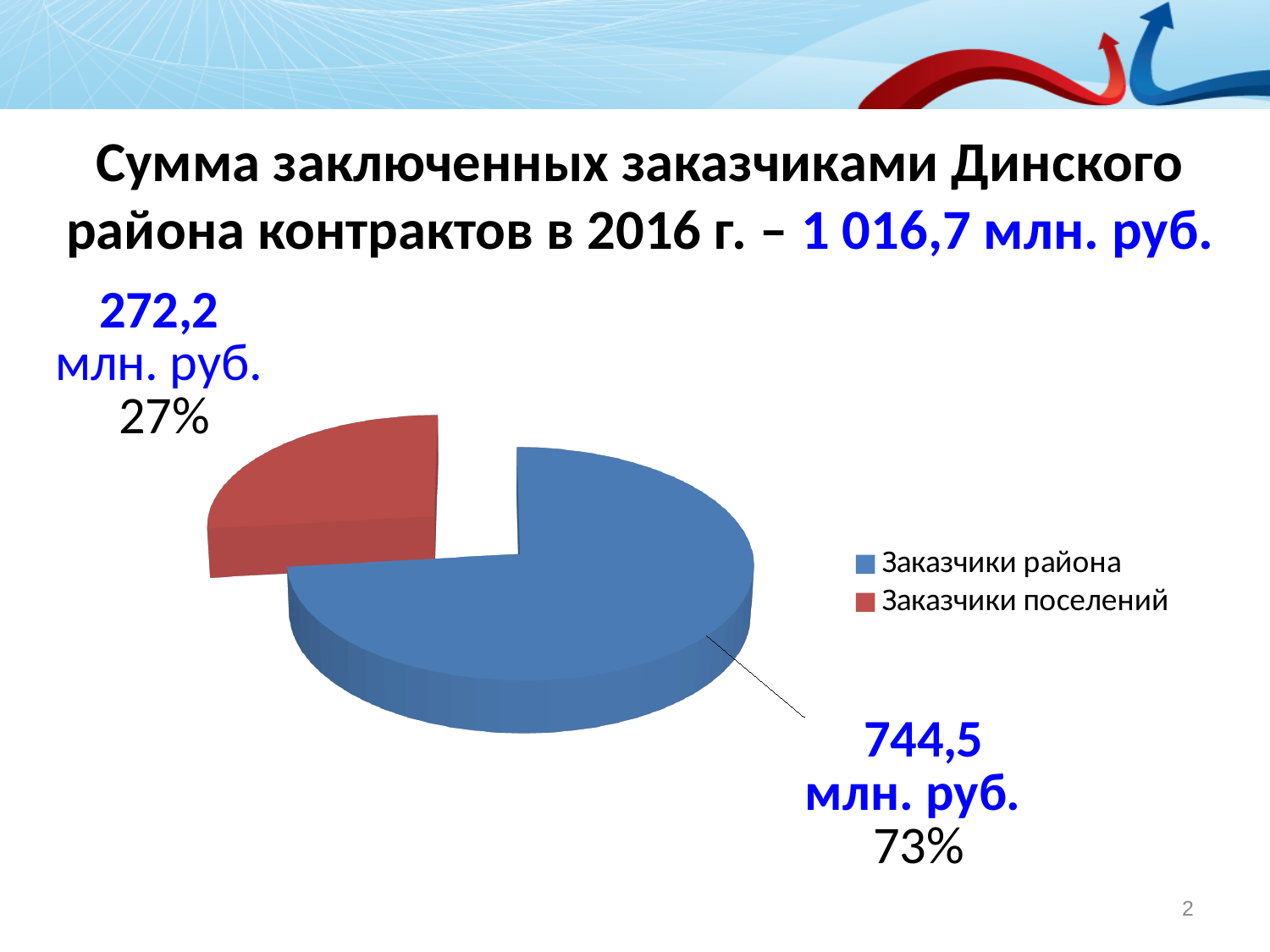
What kind of chart is shown on the slide? pie chart How many slices does the pie chart have? 2 Which category has the smallest slice of the pie? Заказчики поселений What is the difference between the values for Заказчики района and Заказчики поселений? 472,3 млн. руб. Which category has the largest slice of the pie? Заказчики района What is the value for Заказчики района? 744,5 млн. руб. Which is larger, the value for Заказчики района or for Заказчики поселений? Заказчики района What share of the pie does Заказчики района represent? 73% What colour is the slice for Заказчики поселений? red How many entries does the legend list? 2 What is the value for Заказчики поселений? 272,2 млн. руб. What share of the pie does Заказчики поселений represent? 27%